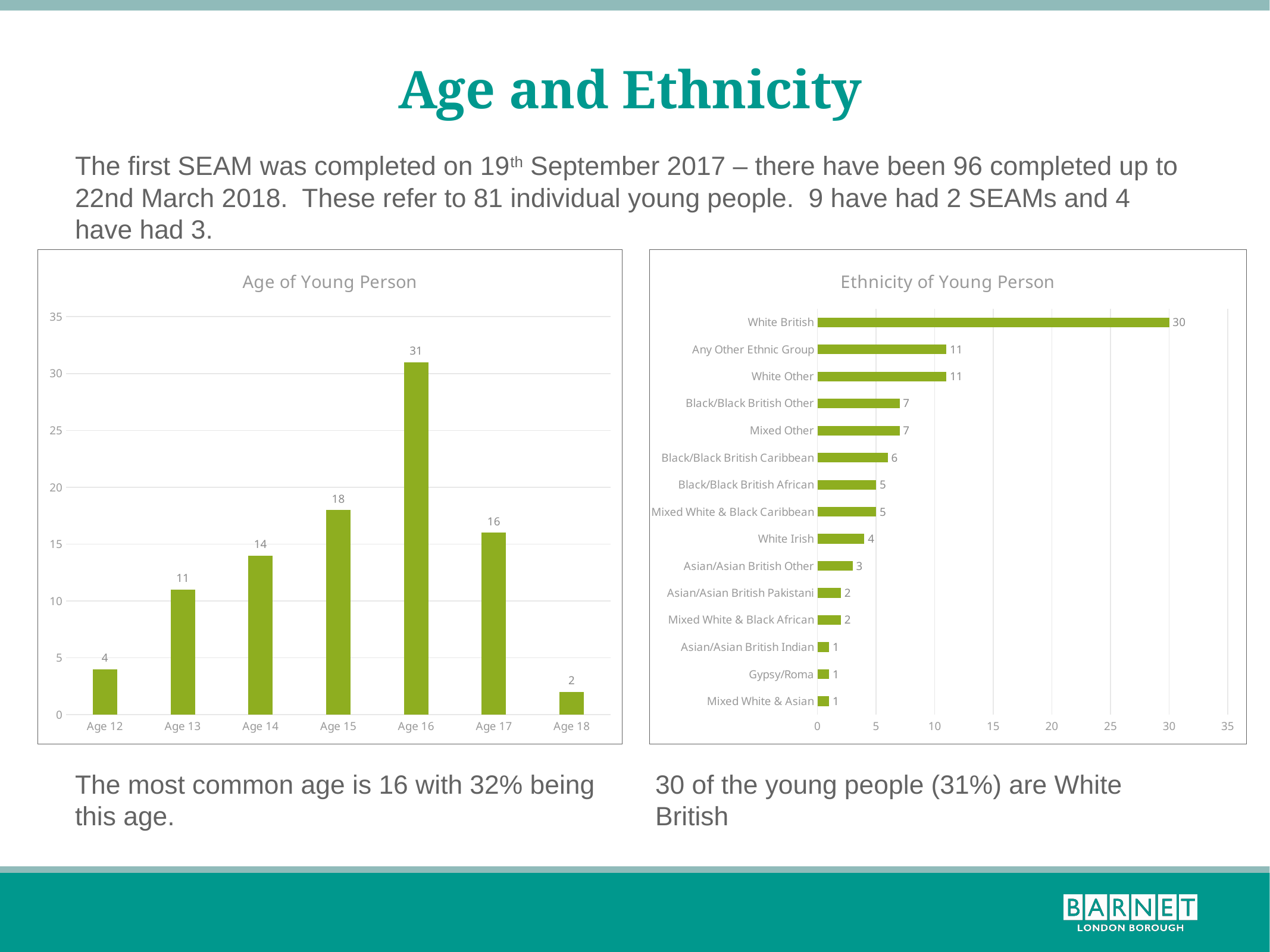
In the 'Age of Young Person' chart, which age has the lowest value? Age 18 In the 'Ethnicity of Young Person' chart, how many ethnicity categories are listed? 15 What is the title of the chart on the right of the slide? Ethnicity of Young Person In the 'Age of Young Person' chart, what is the value for Age 16? 31 In the 'Age of Young Person' chart, what is the difference between the values for Age 15 and Age 13? 7 What kind of chart is the 'Age of Young Person' chart? bar chart In the 'Age of Young Person' chart, how many age categories are shown? 7 In the 'Ethnicity of Young Person' chart, what is the value for Black/Black British Caribbean? 6 In the 'Age of Young Person' chart, do the values rise or fall from Age 12 to Age 16? rise In the 'Ethnicity of Young Person' chart, what is the difference between White British and White Other? 19 In the 'Ethnicity of Young Person' chart, which is larger, White Irish or Asian/Asian British Other? White Irish In the 'Ethnicity of Young Person' chart, which category has the highest value? White British